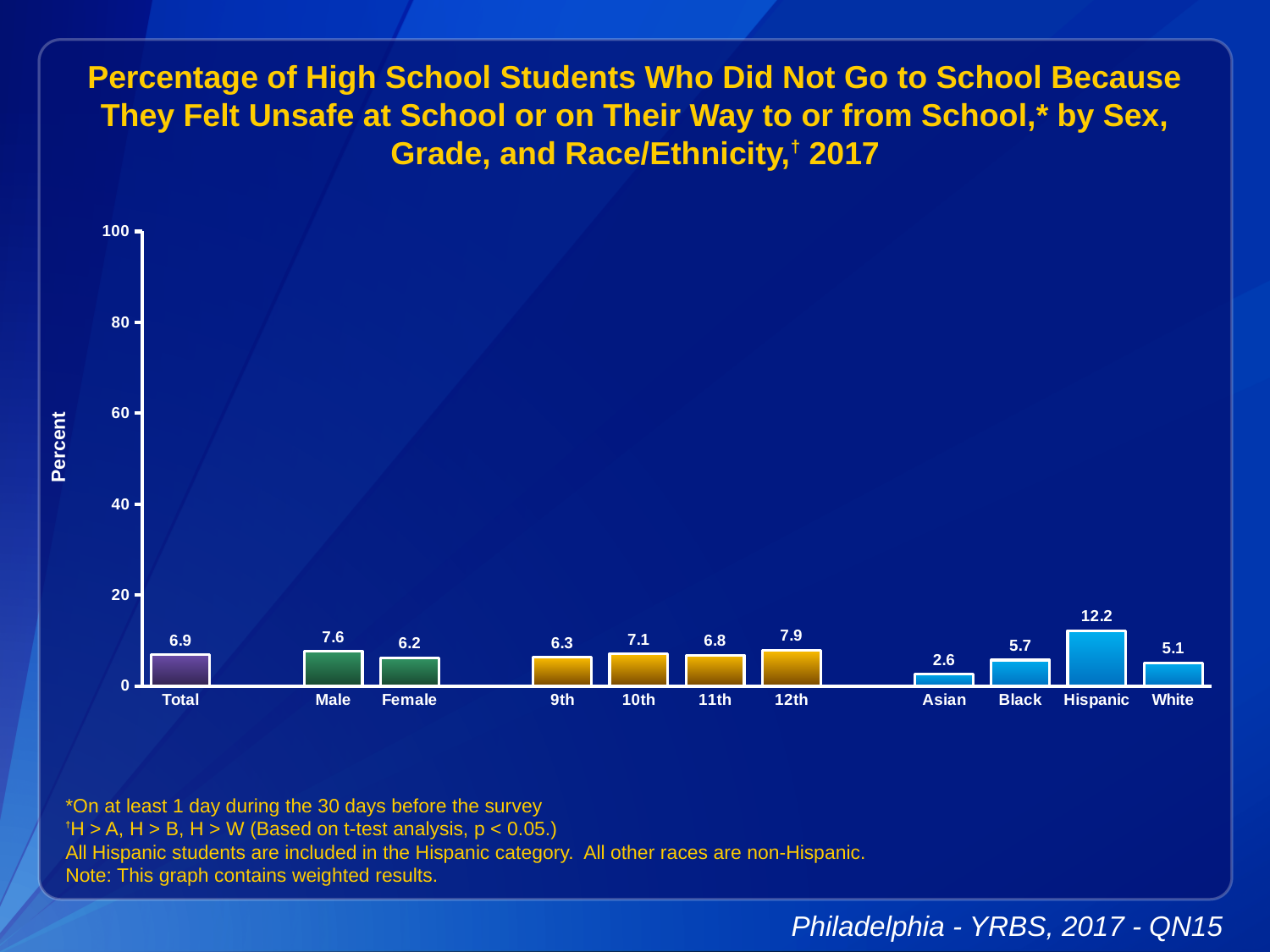
What is the value for Total? 6.9 How many categories are shown on the x axis? 11 Which category has the lowest value? Asian What kind of chart is this? bar chart What is the label on the y axis? Percent What is the difference between the Male and Female values? 1.4 Do the values rise or fall from 11th grade to 12th grade? rise Which is larger, the value for 9th grade or 12th grade? 12th What is the value for 10th grade? 7.1 Which category has the highest value? Hispanic Is the value for Hispanic greater or less than 20? less What is the value for Hispanic students? 12.2